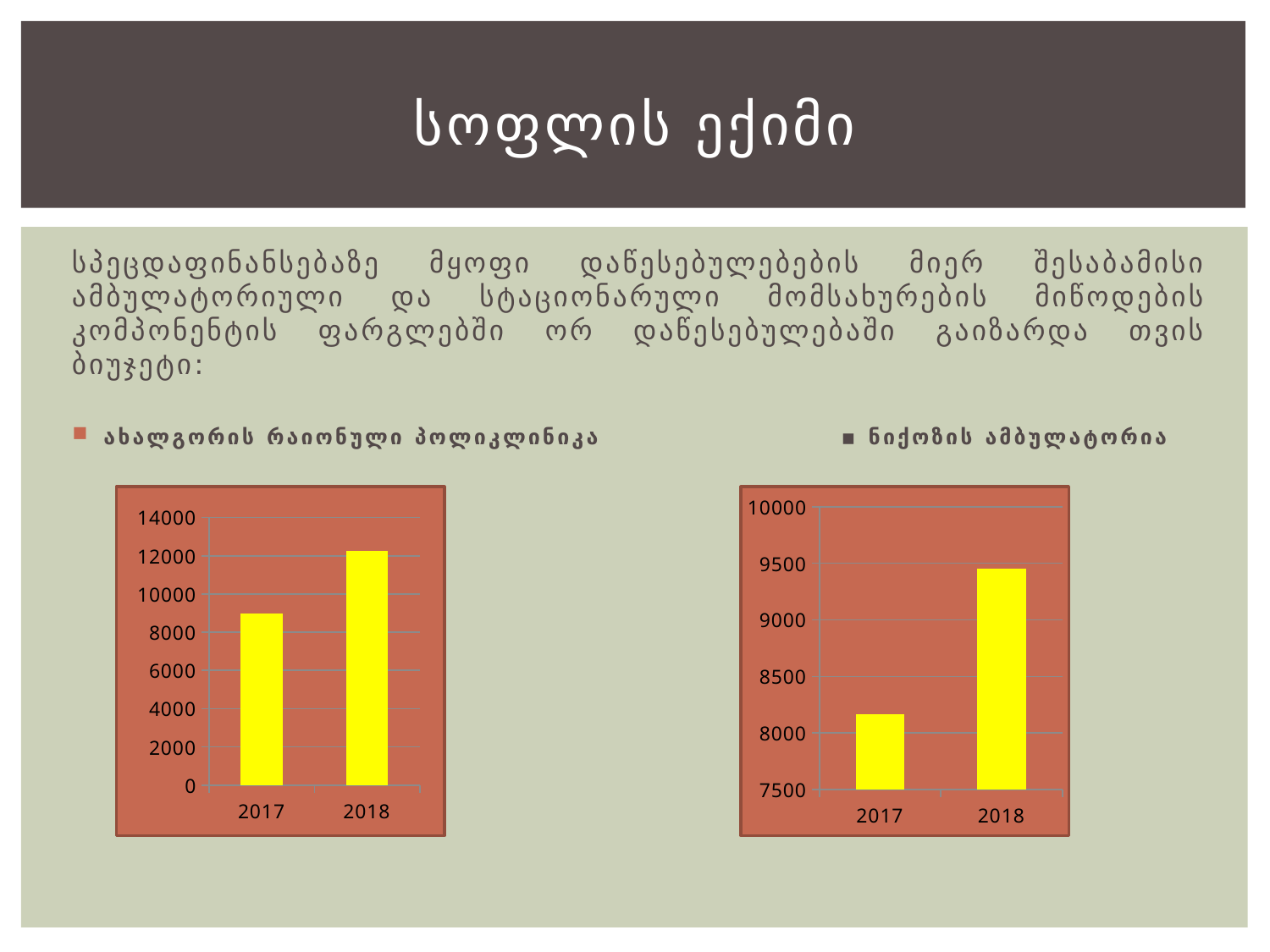
In the left chart, is the value for 2017 greater or less than 10000? less In the right chart, is the value for 2018 greater or less than 9000? greater What kind of chart is the left chart on the slide? bar chart In the left chart, is the value for 2018 greater or less than 10000? greater What kind of chart is the right chart on the slide? bar chart In the right chart, do the values rise or fall from 2017 to 2018? rise In the left chart, how many categories are shown on the x axis? 2 In the right chart, which year has the lower value? 2017 In the left chart, which year has the higher value? 2018 What colour are the bars in the left chart? yellow In the right chart, how many bars are plotted? 2